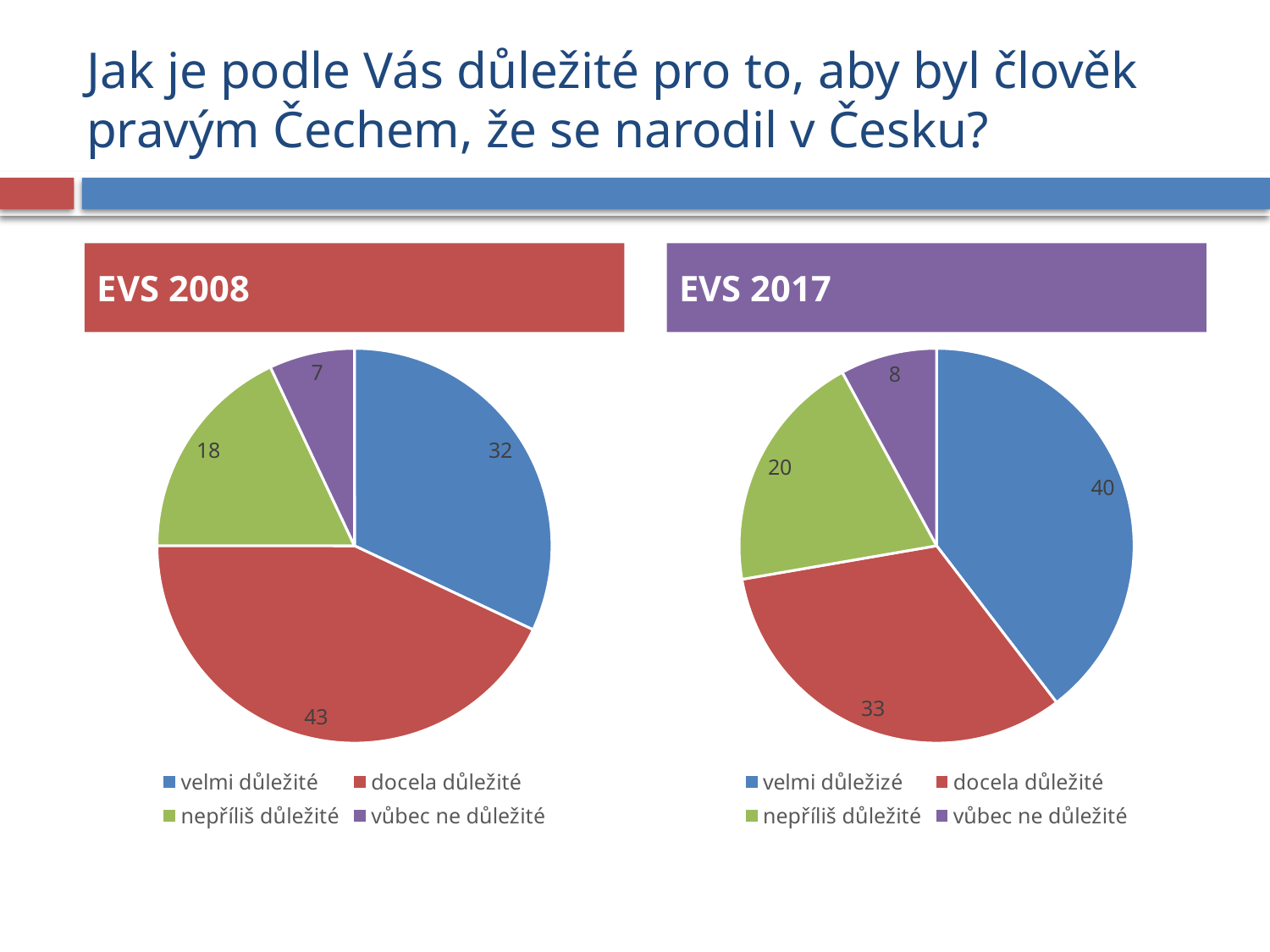
In the EVS 2017 chart, which category has the smallest slice? vůbec ne důležité What kind of chart is the EVS 2017 chart? pie chart In the EVS 2017 chart, what colour is the "docela důležité" slice? red In the EVS 2008 chart, what is the value for "vůbec ne důležité"? 7 In the EVS 2017 chart, what is the value for "nepříliš důležité"? 20 In the EVS 2008 chart, what is the value for "docela důležité"? 43 In the EVS 2017 chart, what is the value for "velmi důležizé"? 40 In the EVS 2008 chart, which category has the largest slice? docela důležité In the EVS 2008 chart, which is larger: the value for "velmi důležité" or the value for "nepříliš důležité"? velmi důležité In the EVS 2017 chart, what is the difference between the values for "velmi důležizé" and "docela důležité"? 7 How many slices does the EVS 2008 chart have? 4 In the EVS 2008 chart, what share of the pie does the "velmi důležité" slice represent? 32%